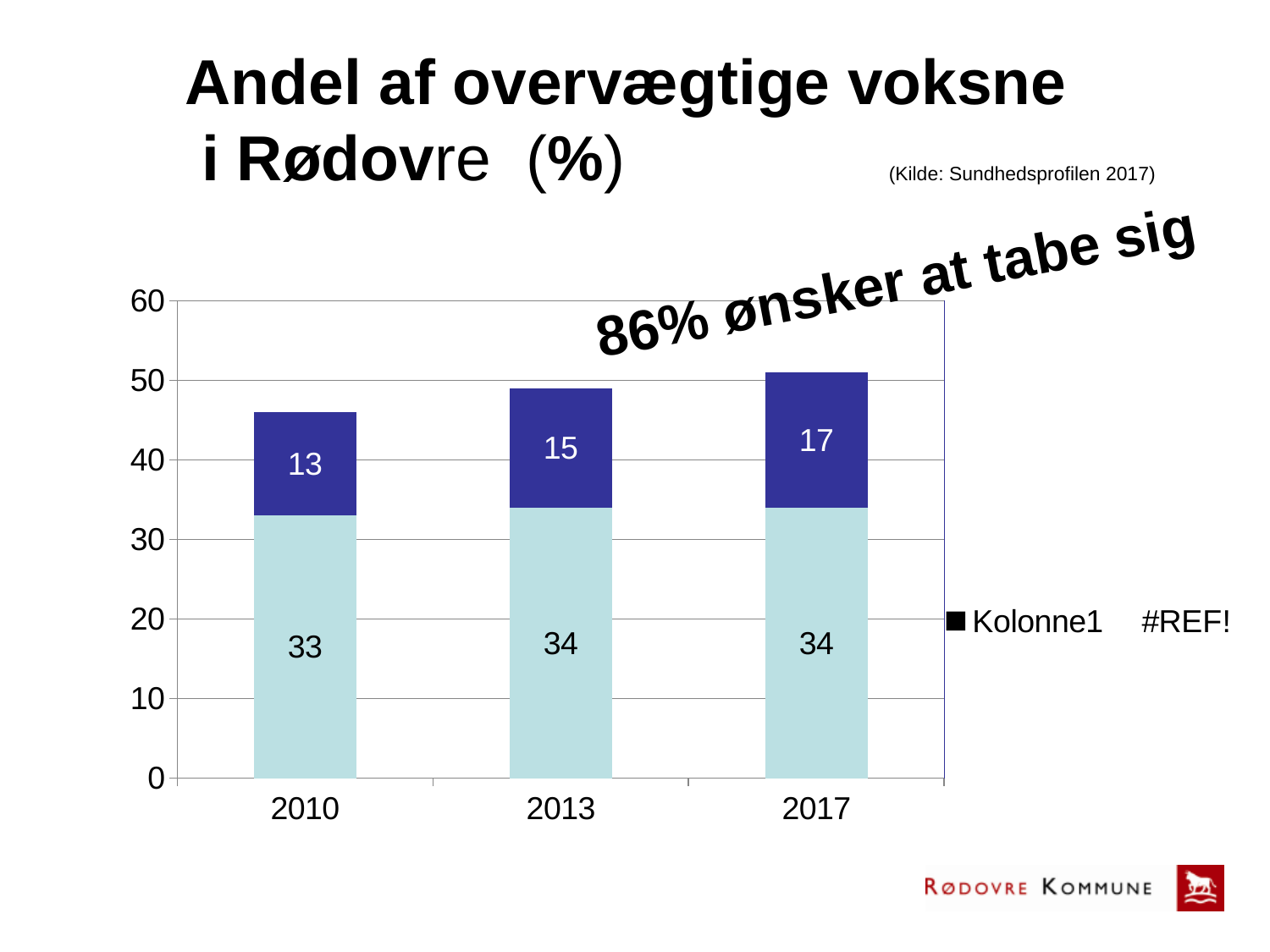
What is the value of the light blue segment for 2010? 33 What is the value of the dark blue segment for 2017? 17 Which year has the highest dark blue segment value? 2017 What type of chart is shown on the slide? stacked bar chart How many years are shown on the x axis of the chart? 3 What is the value of the light blue segment for 2017? 34 What is the value of the dark blue segment for 2013? 15 What is the total of the stacked bar for 2010? 46 What is the total of the stacked bar for 2017? 51 Do the dark blue segment values rise or fall from 2010 to 2017? rise Which year has the lowest dark blue segment value? 2010 What is the difference between the dark blue segment values for 2017 and 2010? 4